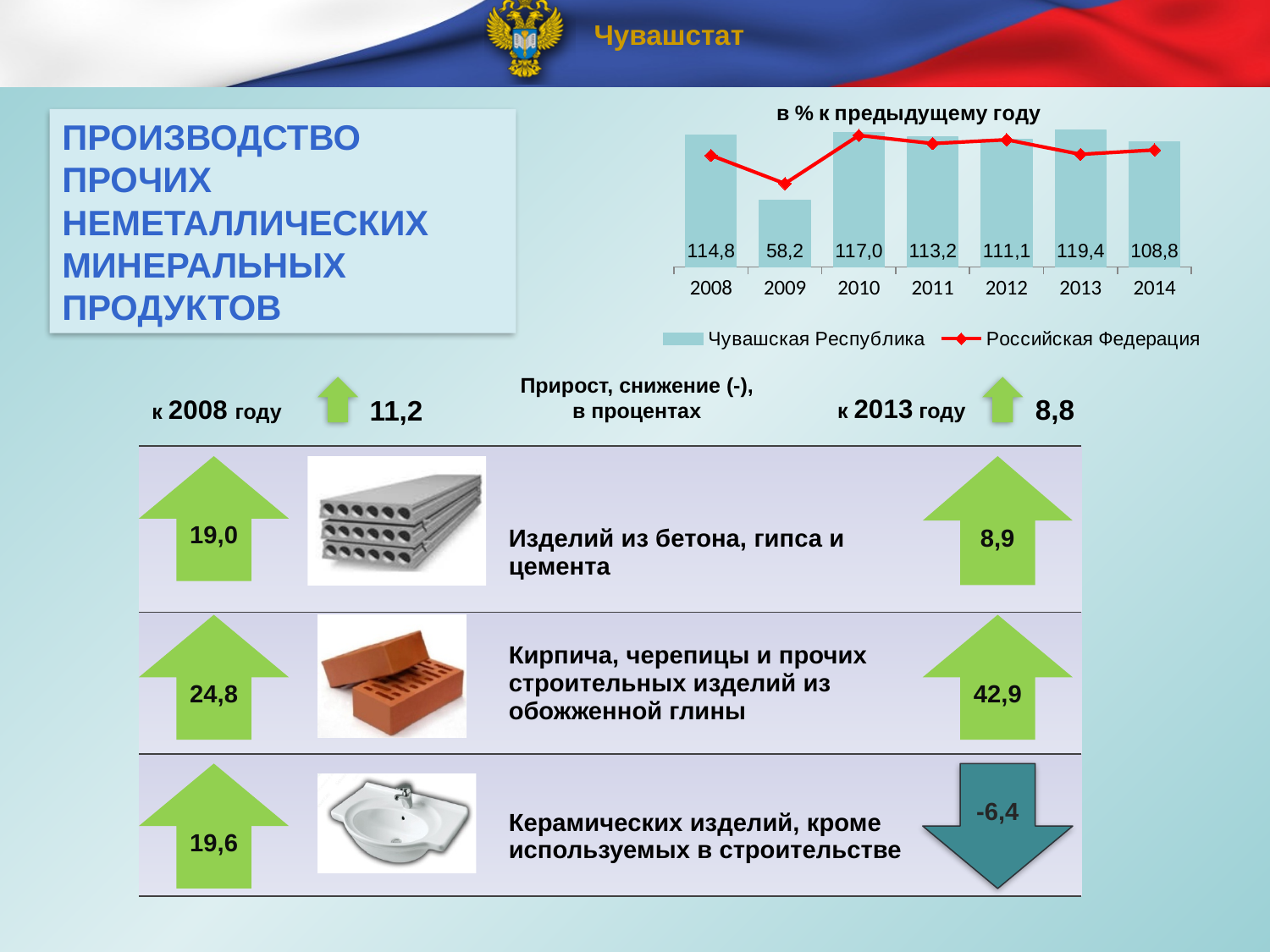
Which year has the larger value for Чувашская Республика, 2010 or 2012? 2010 What is the value for Чувашская Республика in 2013? 119,4 What kind of chart is used to show the Чувашская Республика series? bar chart What is the difference between the Чувашская Республика values for 2013 and 2014? 10,6 How many series does the chart legend list? 2 In which year is the value for Чувашская Республика the highest? 2013 What is the value for Чувашская Республика in 2014? 108,8 Do the values for Чувашская Республика rise or fall from 2010 to 2012? fall How many years are shown on the x axis of the chart? 7 What is the value for Чувашская Республика in 2009? 58,2 What is the difference between the Чувашская Республика values for 2008 and 2009? 56,6 In which year is the value for Чувашская Республика the lowest? 2009